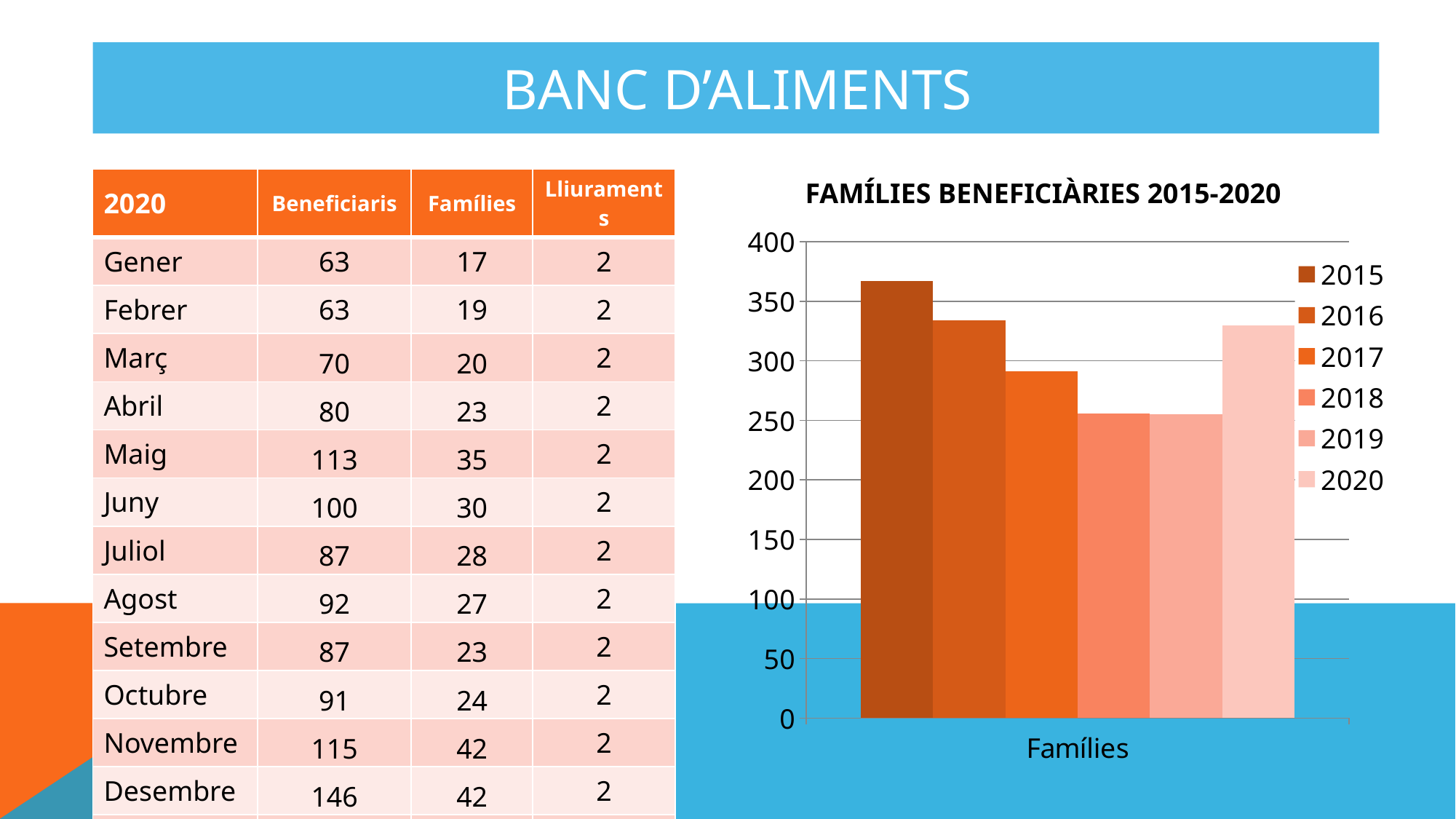
Is the value for 2020 greater or less than 300? greater Which year has the highest bar in the chart? 2015 What kind of chart is shown on the slide? bar chart Is the value for 2016 greater or less than 350? less Which is larger, the value for 2015 or the value for 2020? 2015 How many series does the legend of the chart list? 6 What is the title of the chart? FAMÍLIES BENEFICIÀRIES 2015-2020 Is the value for 2015 greater or less than 350? greater How many categories are shown on the x axis of the chart? 1 Do the bars rise or fall from 2015 through 2019? fall Which is larger, the value for 2017 or the value for 2018? 2017